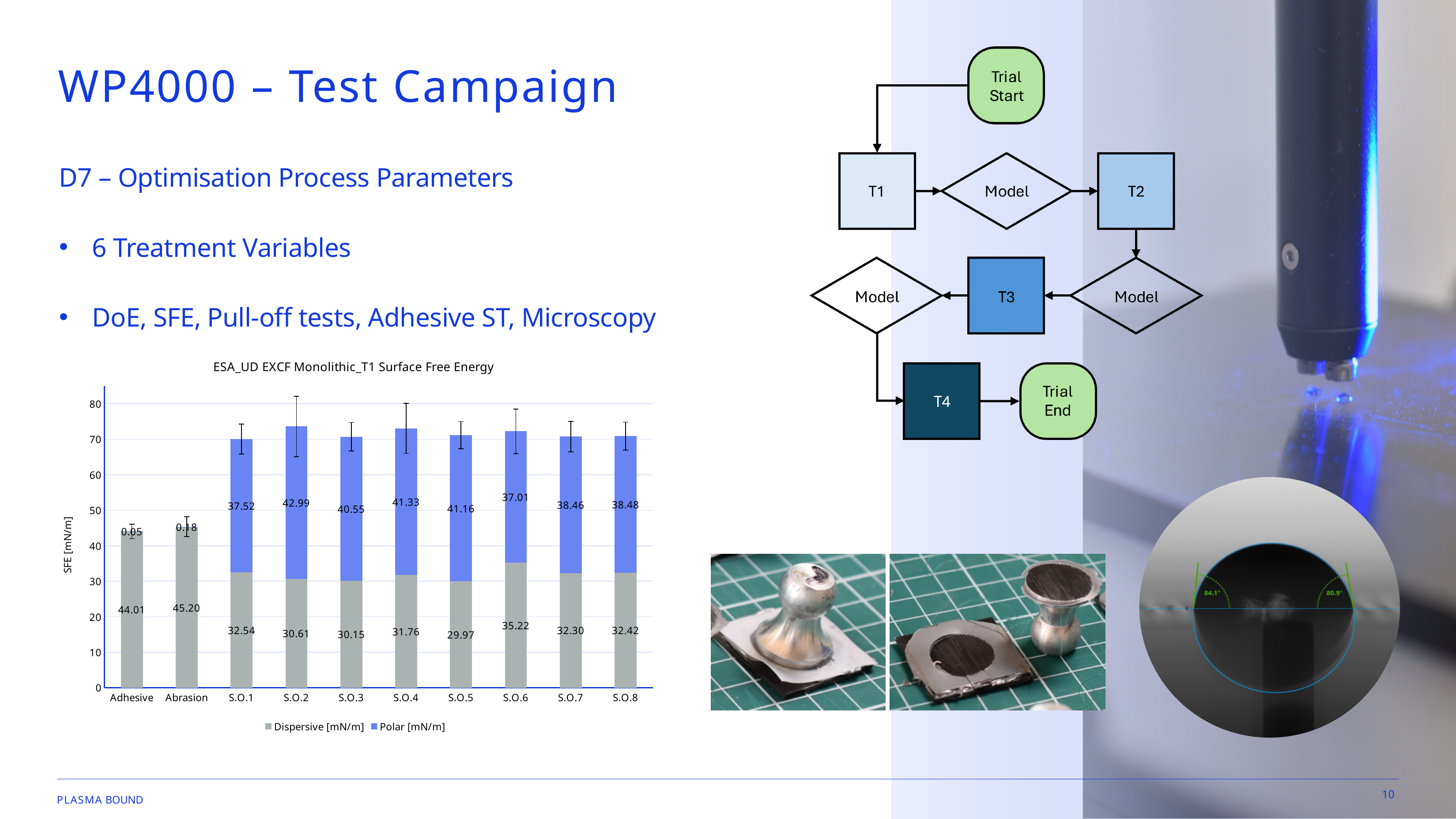
What is the Polar [mN/m] value for S.O.2? 42.99 Which category has the lowest Polar [mN/m] value? Adhesive What is the total stacked value (Dispersive plus Polar) for S.O.2? 73.60 What type of chart is shown on the slide? Stacked bar chart What is the difference between the Polar [mN/m] values for S.O.2 and S.O.1? 5.47 What is the Dispersive [mN/m] value for S.O.5? 29.97 Which is larger, the Dispersive [mN/m] value for S.O.6 or for S.O.3? S.O.6 How many series does the chart legend list? 2 What is the Dispersive [mN/m] value for Abrasion? 45.20 How many categories are shown on the x axis of the chart? 10 Which category has the highest Dispersive [mN/m] value? Abrasion Which category has the highest Polar [mN/m] value? S.O.2